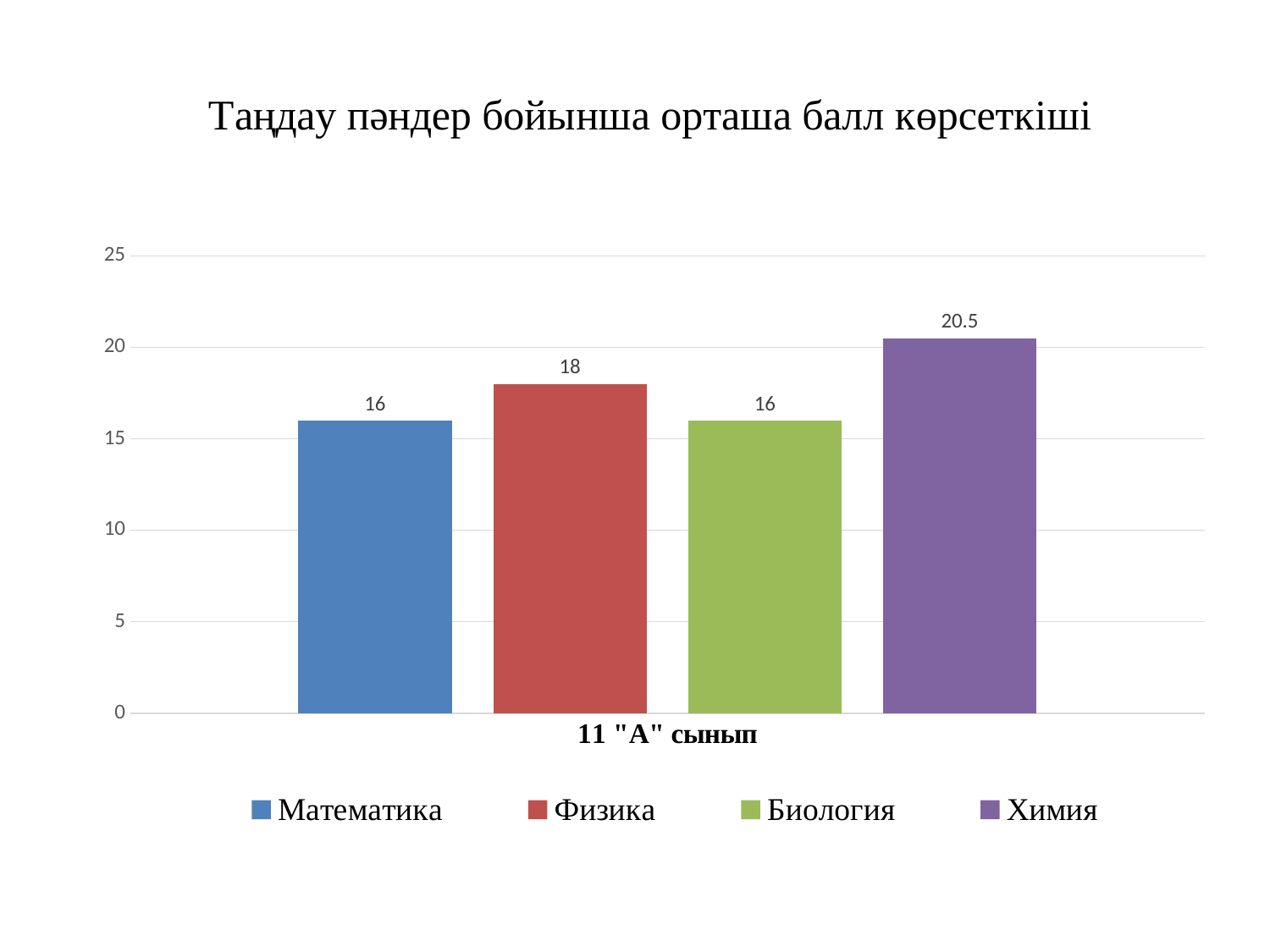
What is the difference between the values for Физика and Биология? 2 What is the value for Химия? 20.5 What is the value for Математика? 16 What is the difference between the values for Химия and Физика? 2.5 What is the value for Физика? 18 How many series does the legend list? 4 Is the value for Химия greater or less than 20? greater What is the title of the chart? Таңдау пәндер бойынша орташа балл көрсеткіші Which series has the highest value? Химия What is the category label shown on the x axis? 11 "А" сынып What kind of chart is shown on the slide? bar chart Which is larger, the value for Физика or the value for Математика? Физика